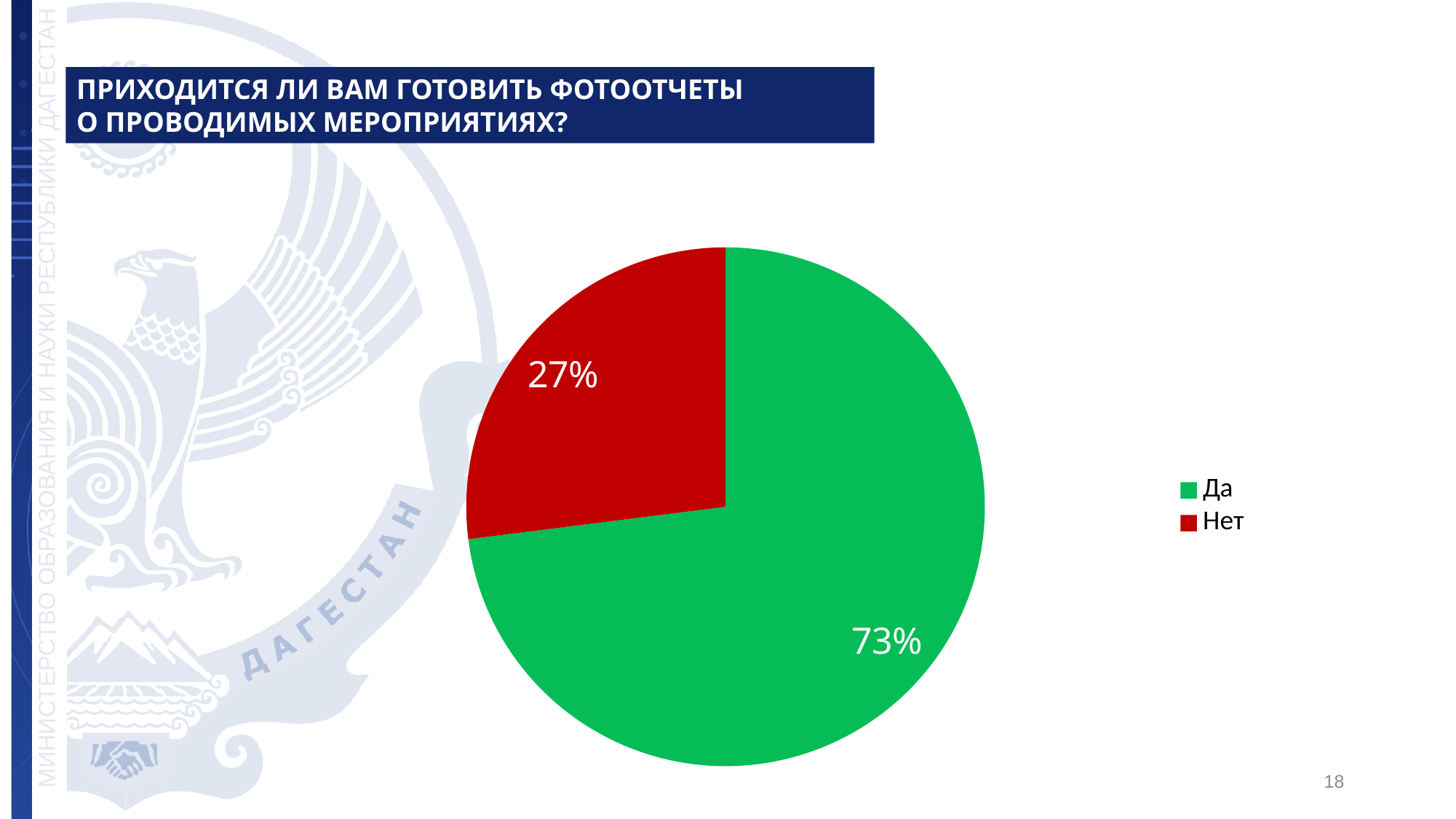
Which slice of the pie is the smallest? Нет What share of the pie does "Нет" represent? 27% Which is larger, the "Да" slice or the "Нет" slice? Да How many slices does the pie chart have? 2 Which slice of the pie is the largest? Да What is the difference in percentage points between the "Да" and "Нет" slices? 46 What colour is the "Нет" slice? Red What colour is the "Да" slice? Green How many entries does the legend list? 2 What share of the pie does "Да" represent? 73% What kind of chart is shown on the slide? Pie chart